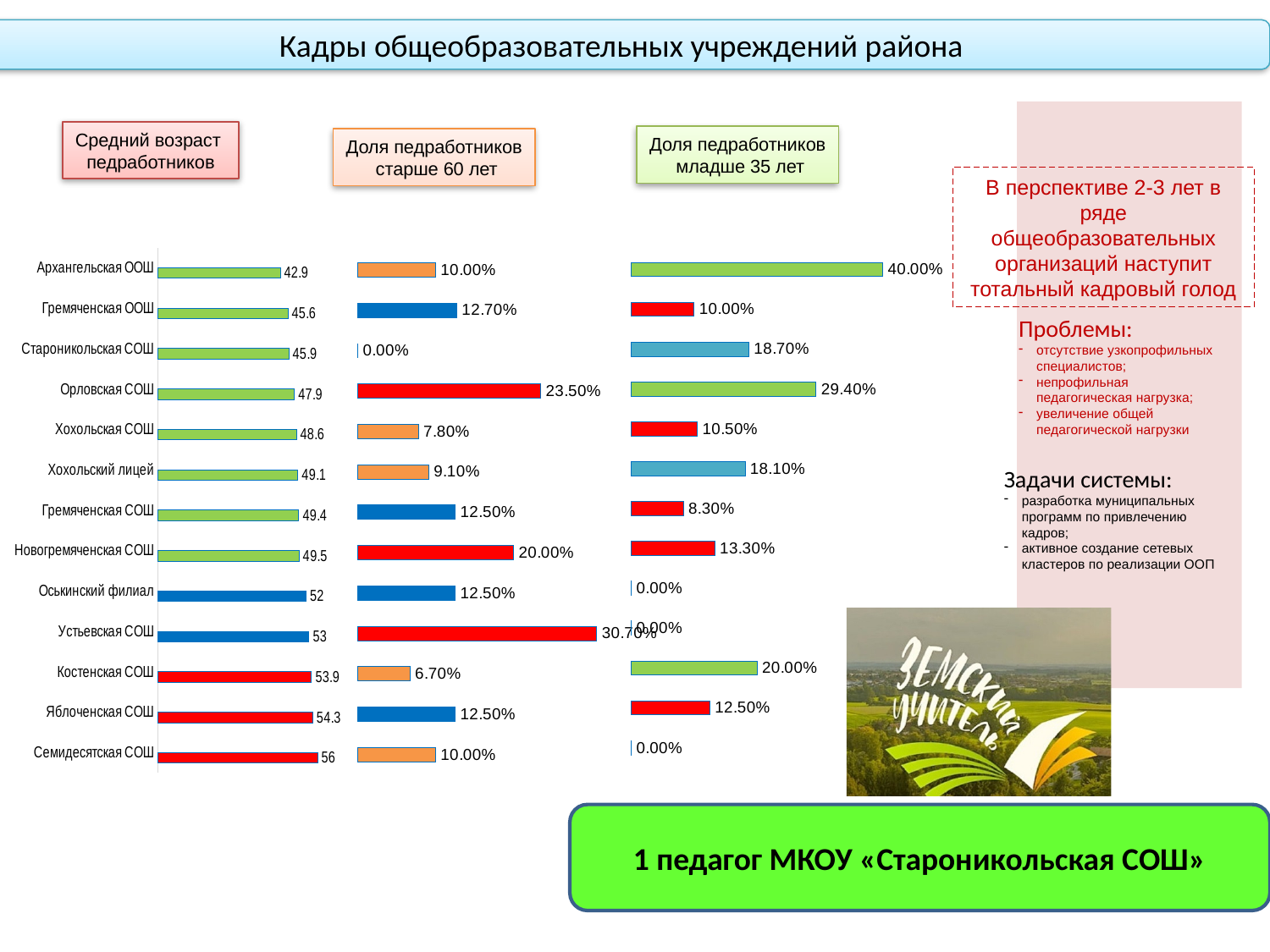
In the 'Средний возраст педработников' chart, which school has the lowest average age? Архангельская ООШ In the 'Доля педработников младше 35 лет' chart, which is larger: Орловская СОШ or Староникольская СОШ? Орловская СОШ In the 'Доля педработников старше 60 лет' chart, which school has the highest value? Устьевская СОШ How many schools are listed as categories in the 'Средний возраст педработников' chart? 13 What type of chart is used for 'Средний возраст педработников'? Bar chart In the 'Средний возраст педработников' chart, what is the value for Семидесятская СОШ? 56 In the 'Доля педработников младше 35 лет' chart, what is the difference between Костенская СОШ and Яблоченская СОШ? 7.50% In the 'Доля педработников старше 60 лет' chart, which school has a value of 0.00%? Староникольская СОШ In the 'Средний возраст педработников' chart, what is the difference between Яблоченская СОШ and Архангельская ООШ? 11.4 In the 'Доля педработников старше 60 лет' chart, what is the value for Орловская СОШ? 23.50% In the 'Средний возраст педработников' chart, do the values increase or decrease from top to bottom? Increase In the 'Доля педработников младше 35 лет' chart, what is the value for Архангельская ООШ? 40.00%